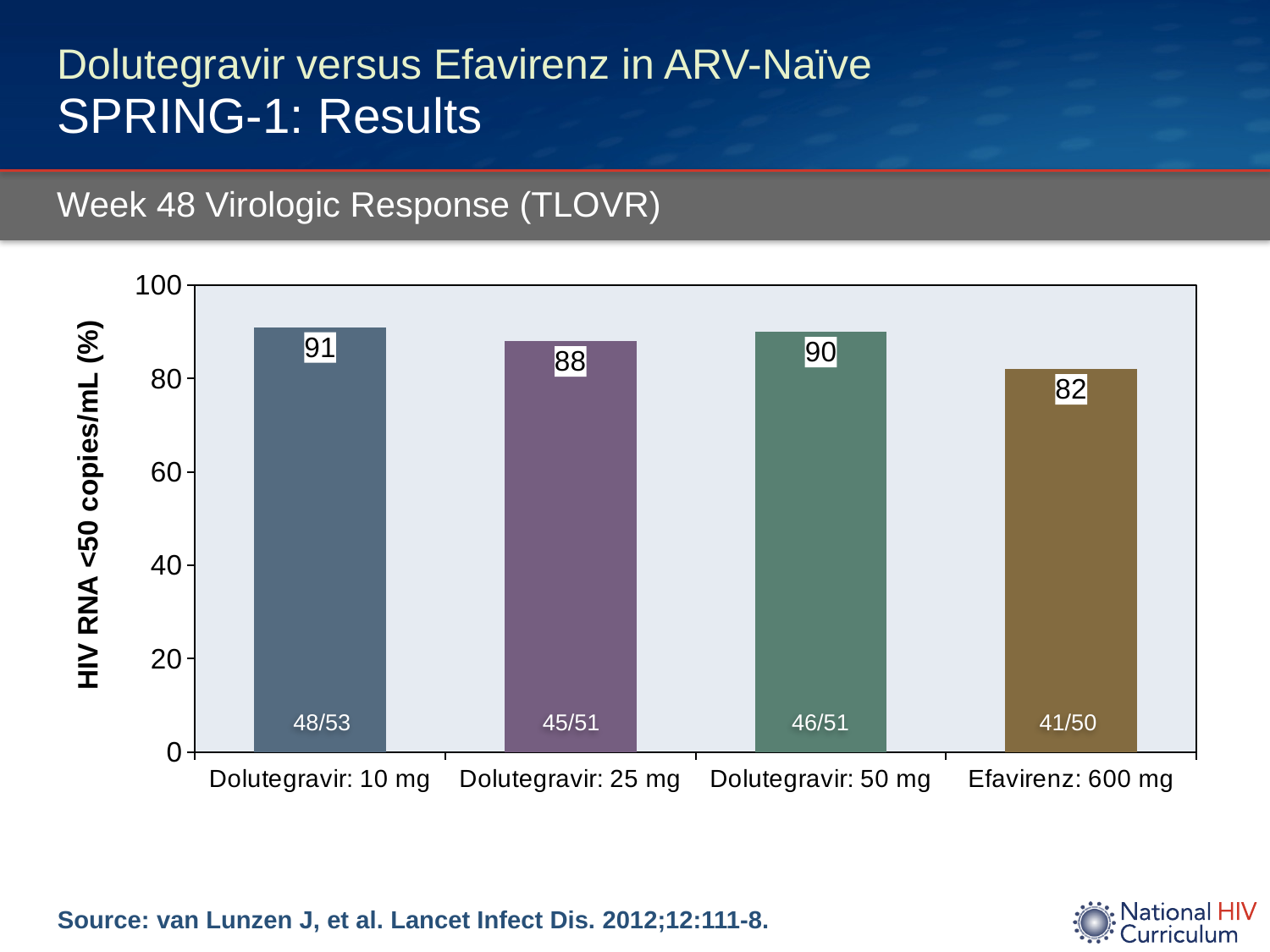
What is the value for Dolutegravir: 25 mg? 88 What is the value for Efavirenz: 600 mg? 82 How many categories are shown on the x axis? 4 What is the difference between the values for Dolutegravir: 50 mg and Efavirenz: 600 mg? 8 Which category has the lowest value? Efavirenz: 600 mg What kind of chart is shown? Bar chart Is the value for Dolutegravir: 50 mg greater or less than 80? greater Which category has the highest value? Dolutegravir: 10 mg Which is larger, the value for Dolutegravir: 25 mg or Efavirenz: 600 mg? Dolutegravir: 25 mg What fraction is printed at the bottom of the Dolutegravir: 50 mg bar? 46/51 What is the value for Dolutegravir: 10 mg? 91 What is the y-axis label of the chart? HIV RNA <50 copies/mL (%)